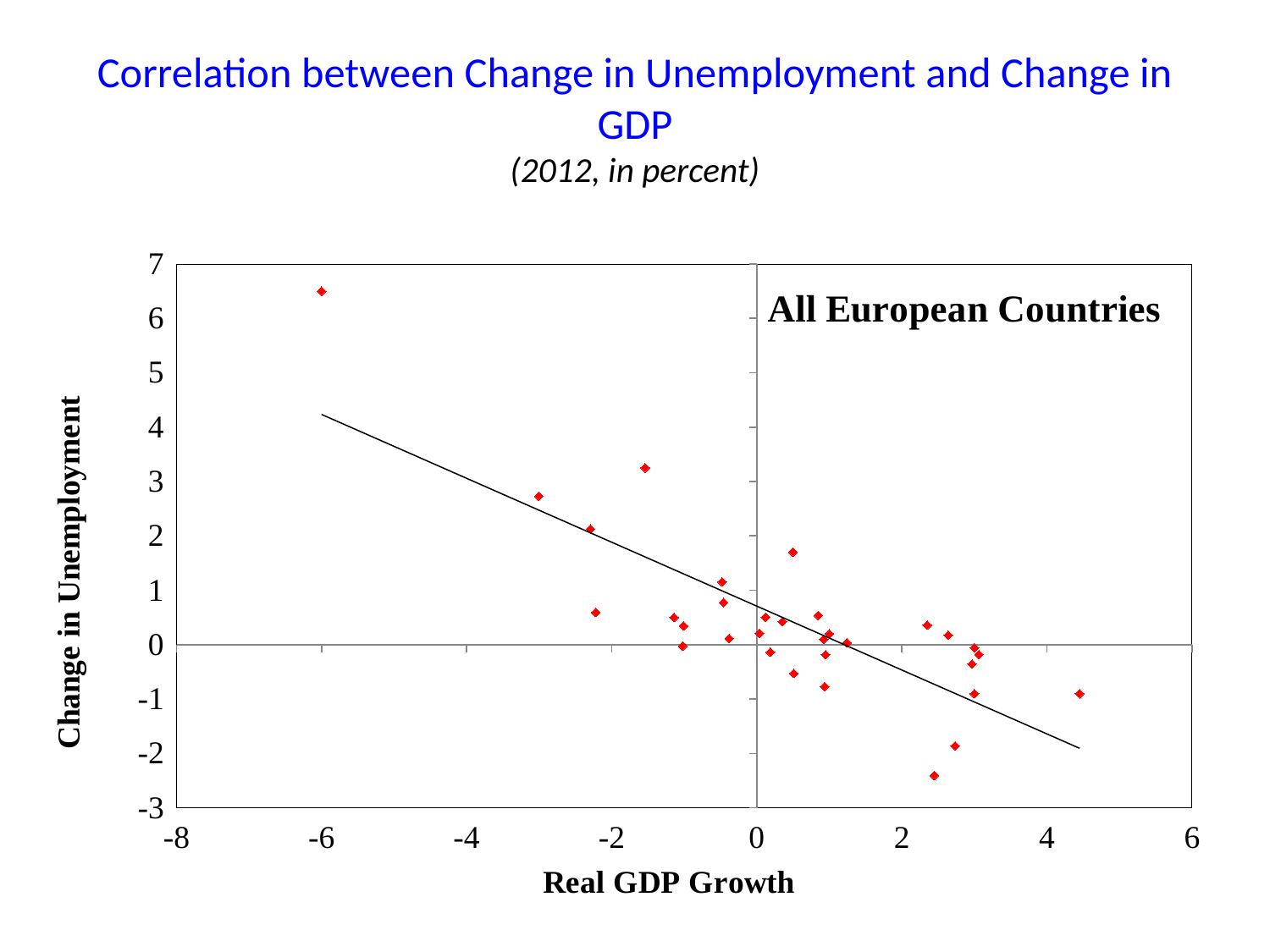
Is the Real GDP Growth of the rightmost point in the chart greater or less than 4? greater Are the points with negative Real GDP Growth mostly above or below a Change in Unemployment of 0? above Is the Real GDP Growth of the lowest point in the chart greater or less than 2? greater Does the fitted line in the chart slope upward or downward from left to right? downward Is the Change in Unemployment of the lowest point in the chart greater or less than -2? less As Real GDP Growth increases along the x axis, does Change in Unemployment tend to rise or fall? fall What is the title of the x axis? Real GDP Growth What kind of chart is shown on the slide? scatter plot What label is printed inside the plot area in the upper right? All European Countries